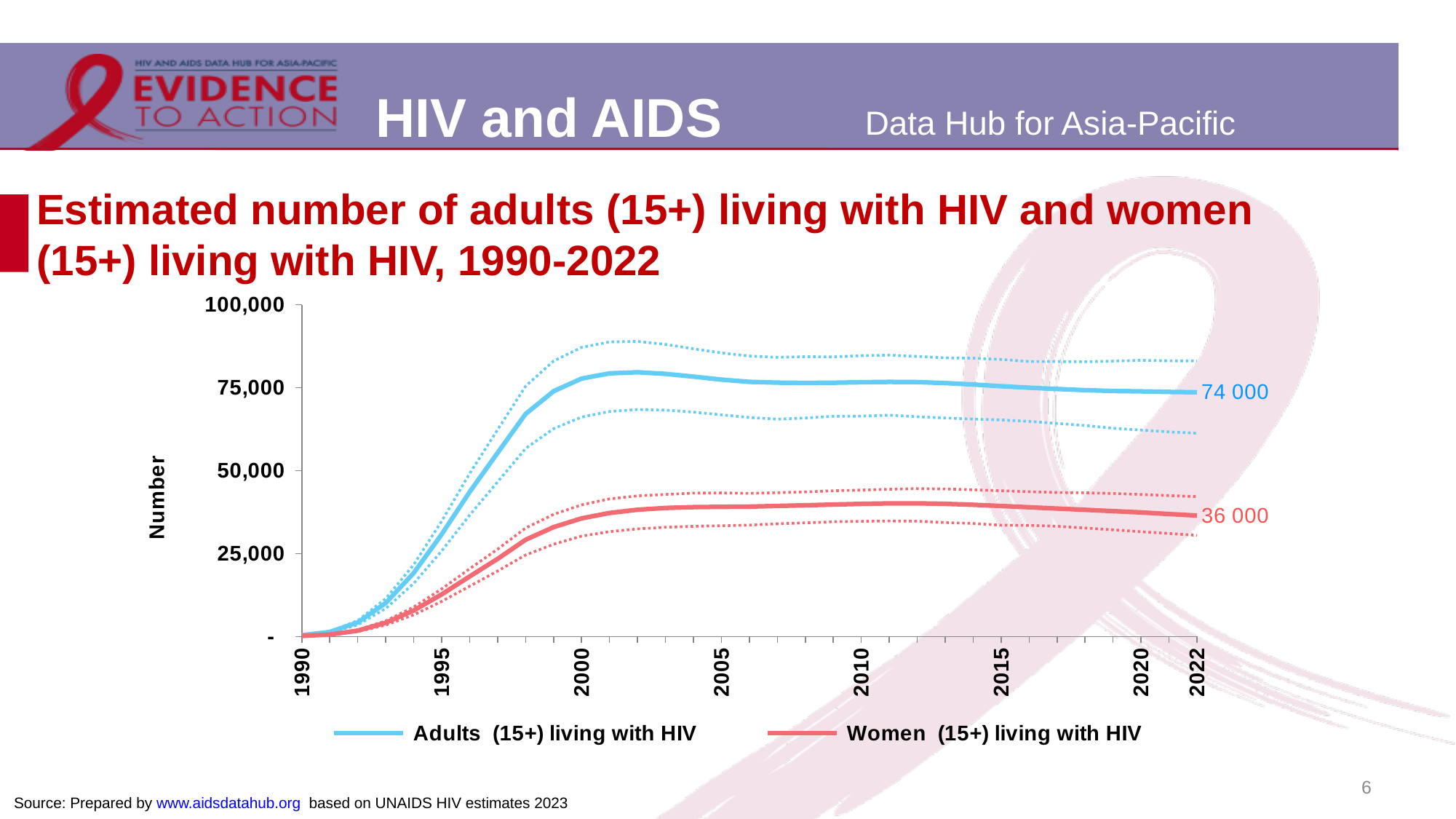
Is the value for Women (15+) living with HIV in 1995 greater or less than 25,000? less What kind of chart is shown on the slide? Line chart Is the value for Adults (15+) living with HIV in 2010 greater or less than 50,000? greater What is the difference between the number of adults (15+) living with HIV and women (15+) living with HIV in 2022? 38 000 What is the label of the vertical axis of the chart? Number How many series does the legend list? 2 What is the estimated number of adults (15+) living with HIV in 2022? 74 000 In 2022, which series has the larger value: Adults (15+) living with HIV or Women (15+) living with HIV? Adults (15+) living with HIV Is the value for Women (15+) living with HIV in 2005 greater or less than 50,000? less What colour is the line for Women (15+) living with HIV? Red What is the estimated number of women (15+) living with HIV in 2022? 36 000 Does the number of adults (15+) living with HIV rise or fall between 1990 and 2000? Rise